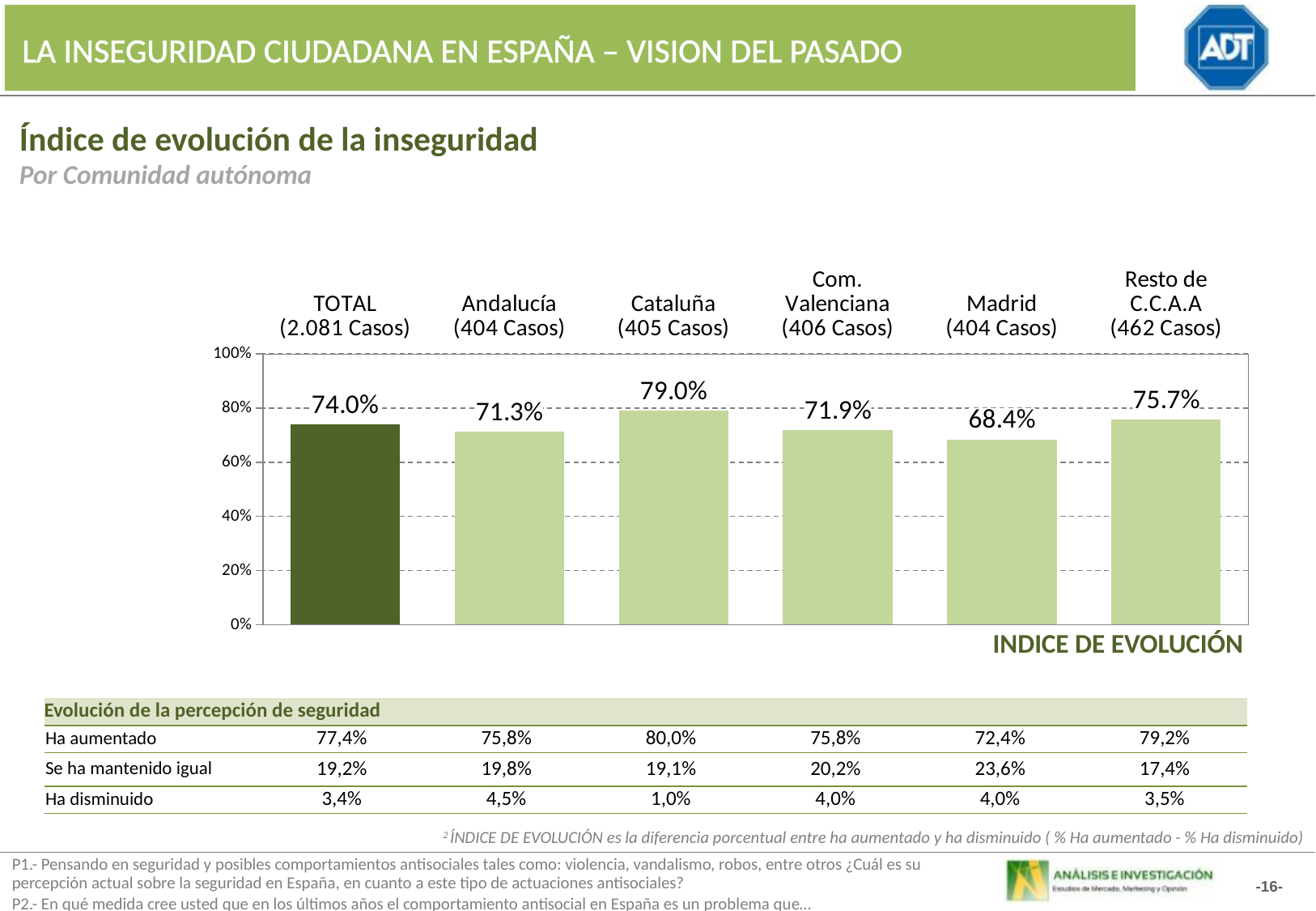
Which category has the lowest value in the chart? Madrid Which category has the highest value in the chart? Cataluña What kind of chart is shown on the slide? bar chart What is the value shown for Cataluña in the chart? 79.0% Is the value for Madrid greater or less than 80%? less Which is larger, the value for Andalucía or the value for Com. Valenciana? Com. Valenciana What is the value shown for TOTAL in the chart? 74.0% How many categories are shown in the chart? 6 What is the value shown for Madrid in the chart? 68.4% What is the value shown for Resto de C.C.A.A in the chart? 75.7% What is the difference between the values for Cataluña and Madrid? 10.6% Which bar in the chart is drawn in a darker green than the others? TOTAL